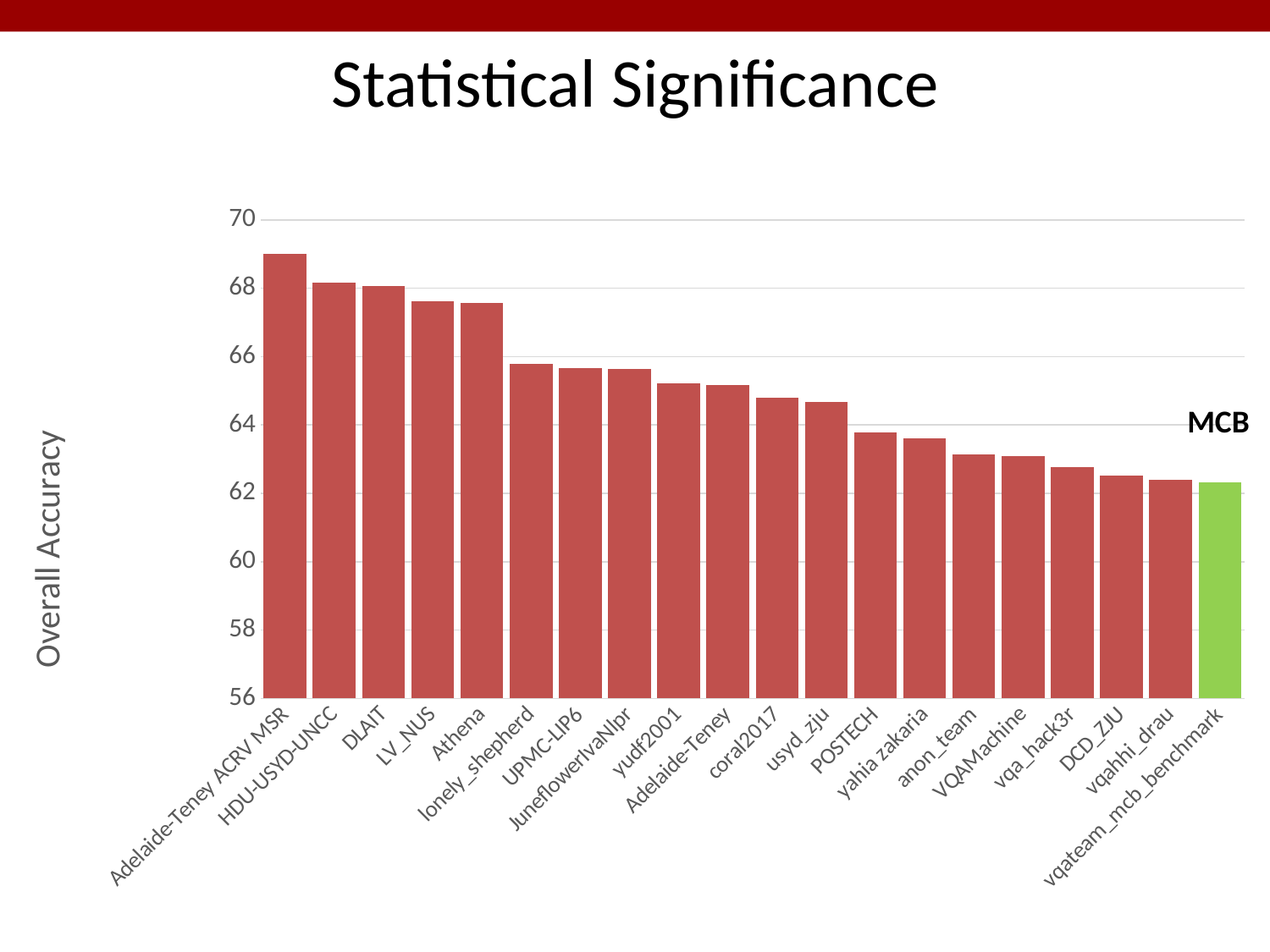
Is the value for usyd_zju greater or less than 64? greater What kind of chart is shown on the slide? bar chart Do the bar values rise or fall from left to right across the chart? fall Is the value for vqateam_mcb_benchmark greater or less than 64? less Is the value for POSTECH greater or less than 64? less Which team's bar is coloured green and labelled MCB? vqateam_mcb_benchmark Which team has the highest overall accuracy in the chart? Adelaide-Teney ACRV MSR What is the label on the vertical axis of the chart? Overall Accuracy Which has a higher overall accuracy, Athena or POSTECH? Athena How many teams (bars) are shown in the chart? 20